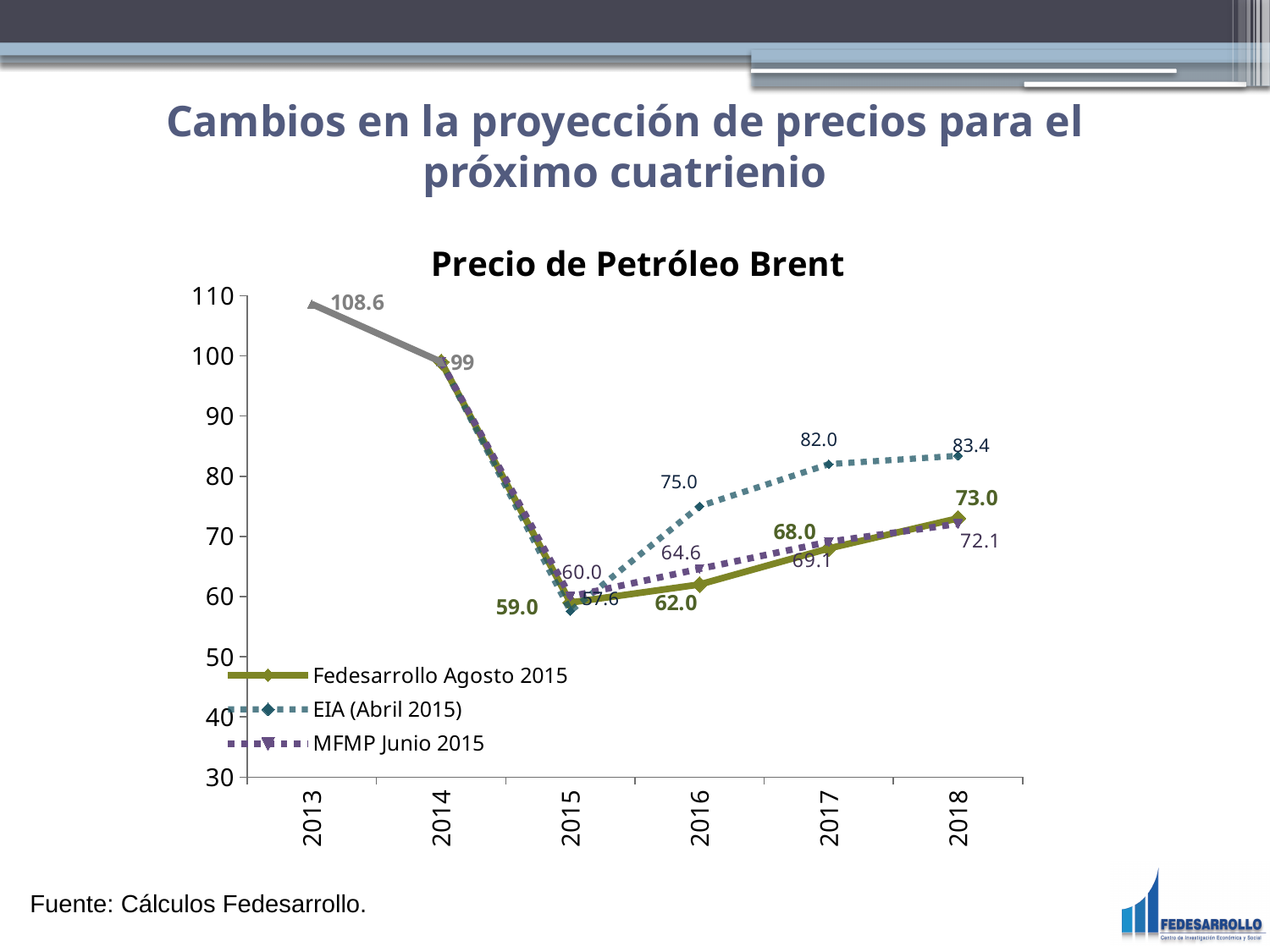
Which series has the highest value in 2018? EIA (Abril 2015) What is the value for Fedesarrollo Agosto 2015 in 2018? 73.0 What is the value for EIA (Abril 2015) in 2017? 82.0 What is the value for MFMP Junio 2015 in 2016? 64.6 What kind of chart is shown on the slide? line chart What is the difference between the EIA (Abril 2015) and Fedesarrollo Agosto 2015 values in 2018? 10.4 What is the title of the chart? Precio de Petróleo Brent Does the Fedesarrollo Agosto 2015 series rise or fall from 2015 to 2018? rise How many series does the legend list? 3 In 2016, which is larger: the EIA (Abril 2015) value or the Fedesarrollo Agosto 2015 value? EIA (Abril 2015) How many years are shown on the x axis? 6 What is the value shown for 2013? 108.6